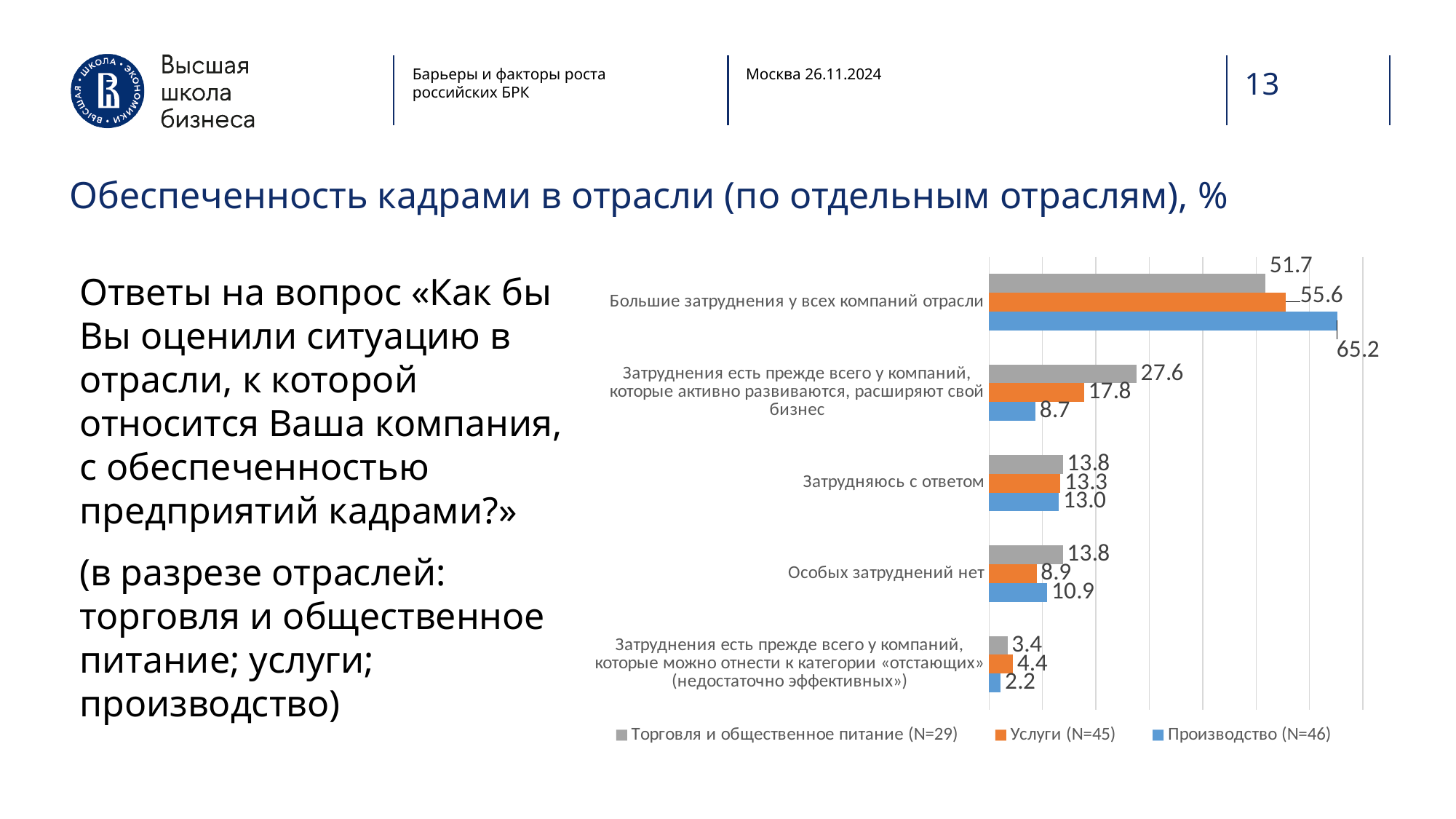
What kind of chart is shown on the slide? bar chart What is the difference between the Услуги (N=45) and Производство (N=46) values in the category «Особых затруднений нет»? 2.0 Which category has the highest value for Торговля и общественное питание (N=29)? Большие затруднения у всех компаний отрасли How many series does the legend list? 3 What is the difference between the Производство (N=46) and Торговля и общественное питание (N=29) values in the category «Большие затруднения у всех компаний отрасли»? 13.5 Which colour represents the series Услуги (N=45) in the chart? orange What is the value for Услуги (N=45) in the category «Затруднения есть прежде всего у компаний, которые активно развиваются, расширяют свой бизнес»? 17.8 Which category has the lowest value for Производство (N=46)? Затруднения есть прежде всего у компаний, которые можно отнести к категории «отстающих» (недостаточно эффективных») What is the value for Производство (N=46) in the category «Большие затруднения у всех компаний отрасли»? 65.2 In the category «Затруднения есть прежде всего у компаний, которые активно развиваются, расширяют свой бизнес», which series has the larger value: Торговля и общественное питание (N=29) or Производство (N=46)? Торговля и общественное питание (N=29) What is the value for Торговля и общественное питание (N=29) in the category «Особых затруднений нет»? 13.8 How many categories are shown on the chart? 5